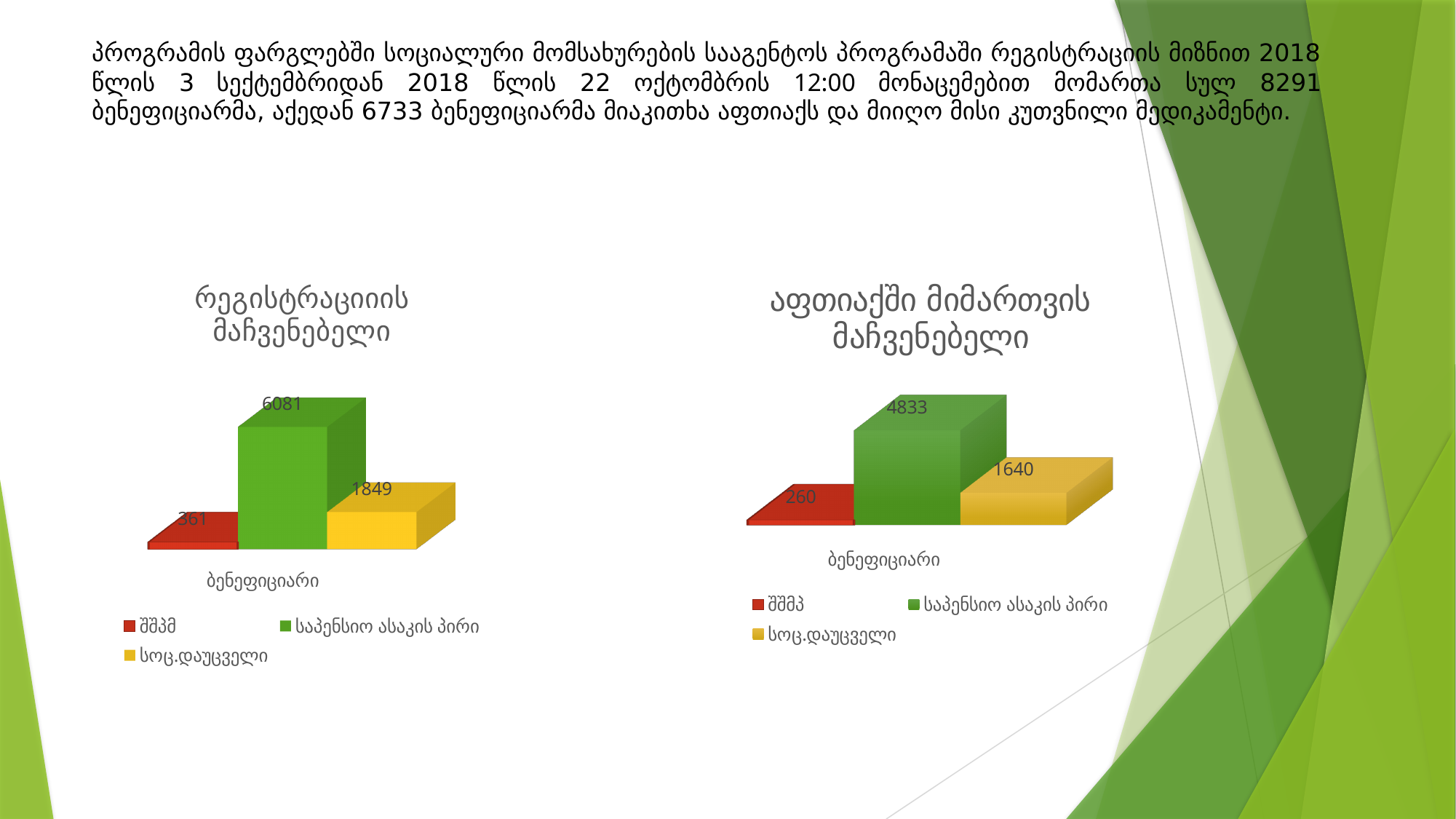
In the chart titled "რეგისტრაციის მაჩვენებელი", which series has the lowest value? შშმპ In the chart titled "რეგისტრაციის მაჩვენებელი", what is the difference between the values for საპენსიო ასაკის პირი and სოც.დაუცველი? 4232 In the chart titled "რეგისტრაციის მაჩვენებელი", what is the value for შშმპ? 361 Which is larger: the value for სოც.დაუცველი in the left chart or the value for სოც.დაუცველი in the right chart? The left chart (1849) In the chart titled "აფთიაქში მიმართვის მაჩვენებელი", what is the value for შშმპ? 260 In the chart titled "რეგისტრაციის მაჩვენებელი", what is the value for საპენსიო ასაკის პირი? 6081 In the chart titled "აფთიაქში მიმართვის მაჩვენებელი", what is the difference between the values for სოც.დაუცველი and შშმპ? 1380 In the chart titled "აფთიაქში მიმართვის მაჩვენებელი", which series has the highest value? საპენსიო ასაკის პირი What kind of chart is the chart titled "აფთიაქში მიმართვის მაჩვენებელი"? Bar chart How many series does the legend of the chart titled "რეგისტრაციის მაჩვენებელი" list? 3 What is the total of the three values shown in the chart titled "აფთიაქში მიმართვის მაჩვენებელი"? 6733 In the chart titled "აფთიაქში მიმართვის მაჩვენებელი", what is the value for სოც.დაუცველი? 1640